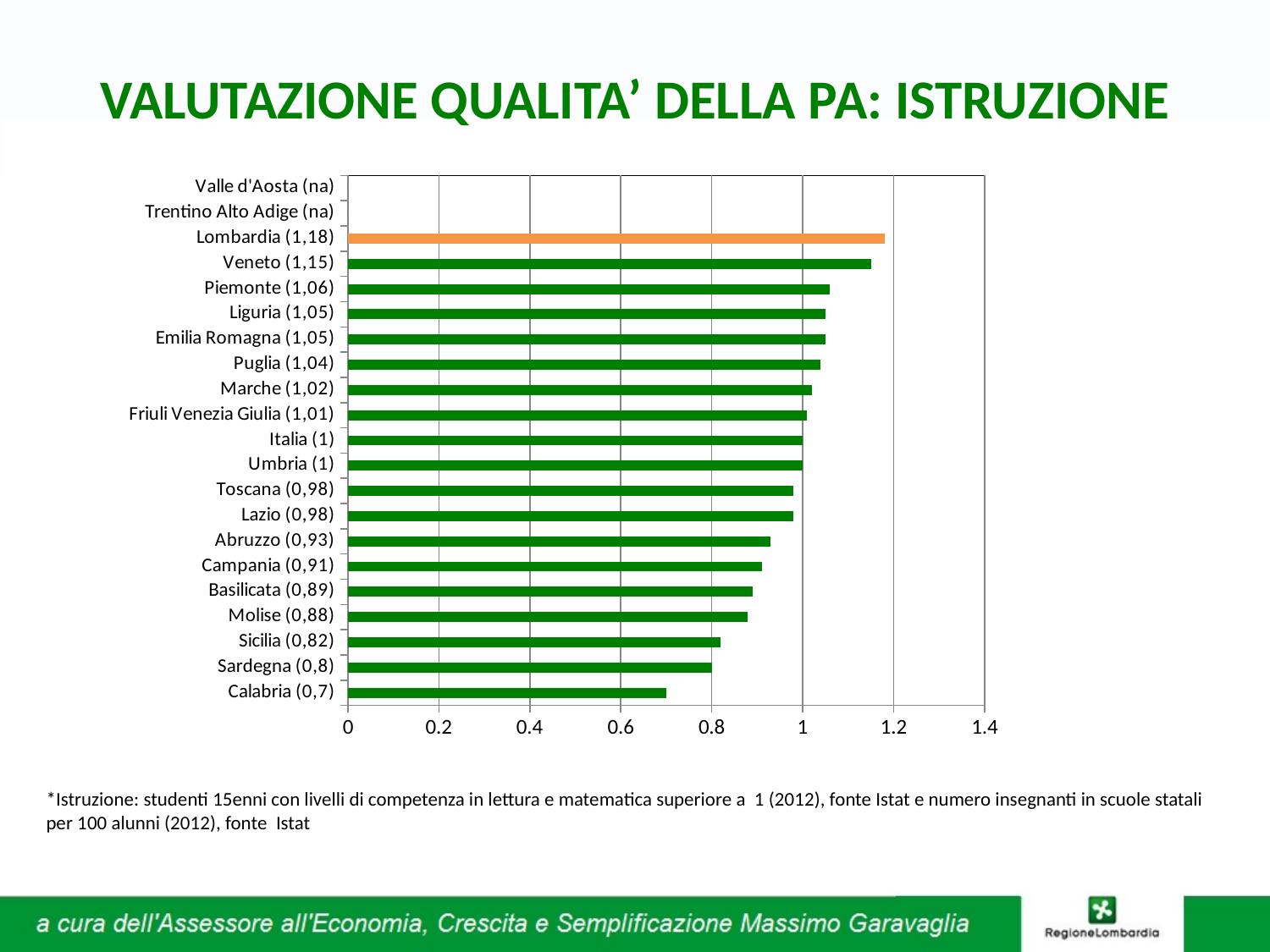
What is the difference between the values for Lombardia and Calabria? 0,48 Which region's bar is drawn in orange instead of green? Lombardia Which has a larger value, Sicilia or Abruzzo? Abruzzo What kind of chart is shown on the slide? bar chart What is the value for Calabria? 0,7 Which region has the highest plotted value? Lombardia How many categories are listed on the vertical axis of the chart? 21 What is the difference between the values for Veneto and Piemonte? 0,09 What is the value for Friuli Venezia Giulia? 1,01 Which region has the lowest plotted value? Calabria What is the value for Lombardia? 1,18 Is the value for Molise greater or less than 1? less